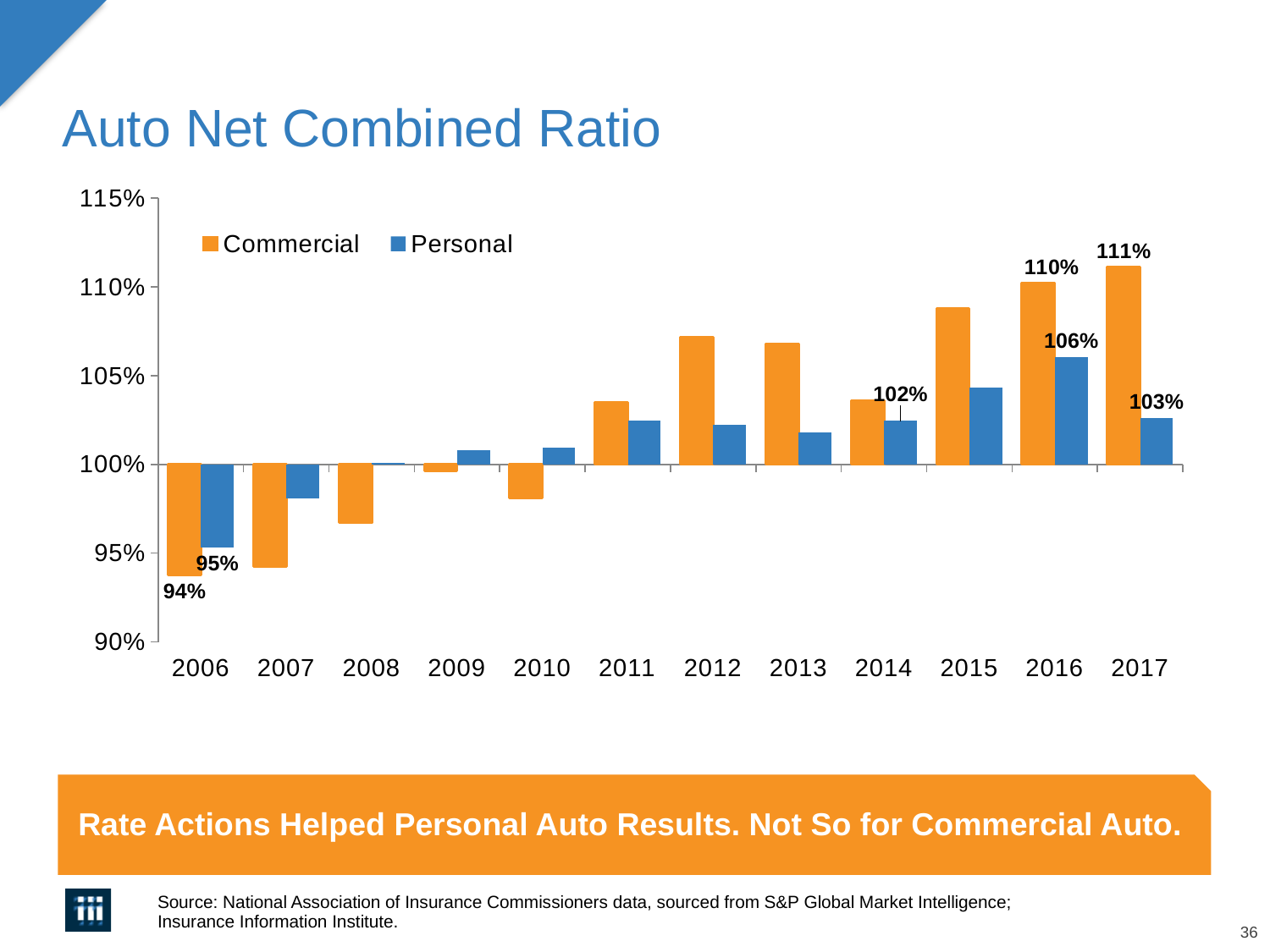
How many series does the legend list? 2 In which year is the Commercial combined ratio highest? 2017 Is the Commercial combined ratio for 2010 greater or less than 100%? less What is the Commercial auto net combined ratio for 2006? 94% In which year is the Personal combined ratio lowest? 2006 How many years are shown on the x axis? 12 What is the difference between the Commercial and Personal combined ratios in 2017? 8 percentage points What is the Personal auto net combined ratio for 2014? 102% What type of chart is shown on the slide? Bar chart In 2016, which is larger, the Commercial or the Personal combined ratio? Commercial Is the Commercial combined ratio for 2012 greater or less than 105%? greater What is the Personal auto net combined ratio for 2016? 106%